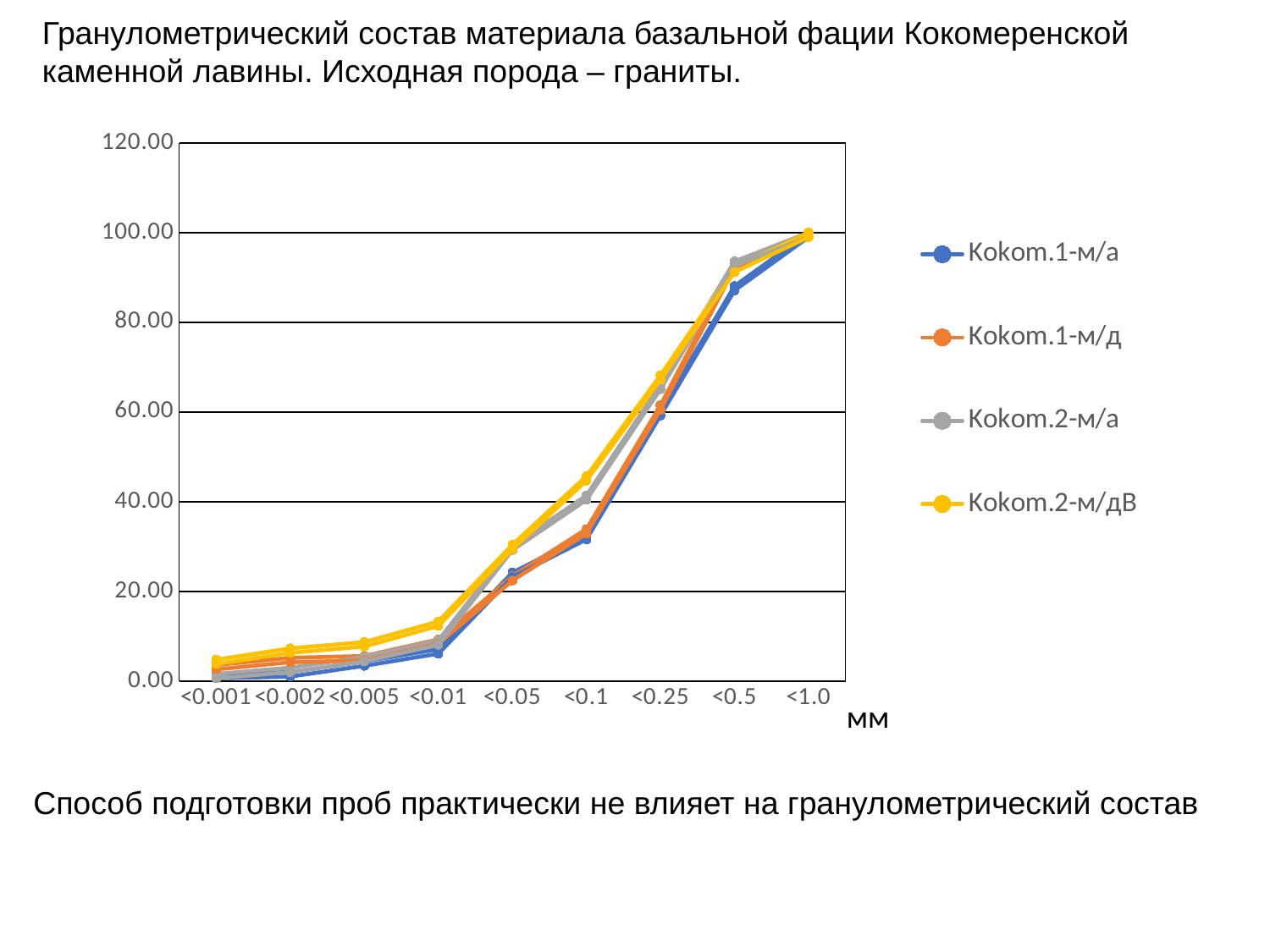
What unit label is shown under the x axis? мм Is the value for Kokom.2-м/дВ at <0.01 greater or less than 20? less Do the values of the series rise or fall along the x axis from <0.001 to <1.0? rise What kind of chart is shown on the slide? line chart How many categories are shown along the x axis? 9 At <0.25, which series has the larger value: Kokom.1-м/а or Kokom.2-м/дВ? Kokom.2-м/дВ Is the value for Kokom.2-м/дВ at <0.25 greater or less than 60? greater Which series is drawn in yellow? Kokom.2-м/дВ Is the value for Kokom.1-м/а at <0.5 greater or less than 80? greater At <0.1, which series has the larger value: Kokom.2-м/дВ or Kokom.1-м/а? Kokom.2-м/дВ How many series does the legend list? 4